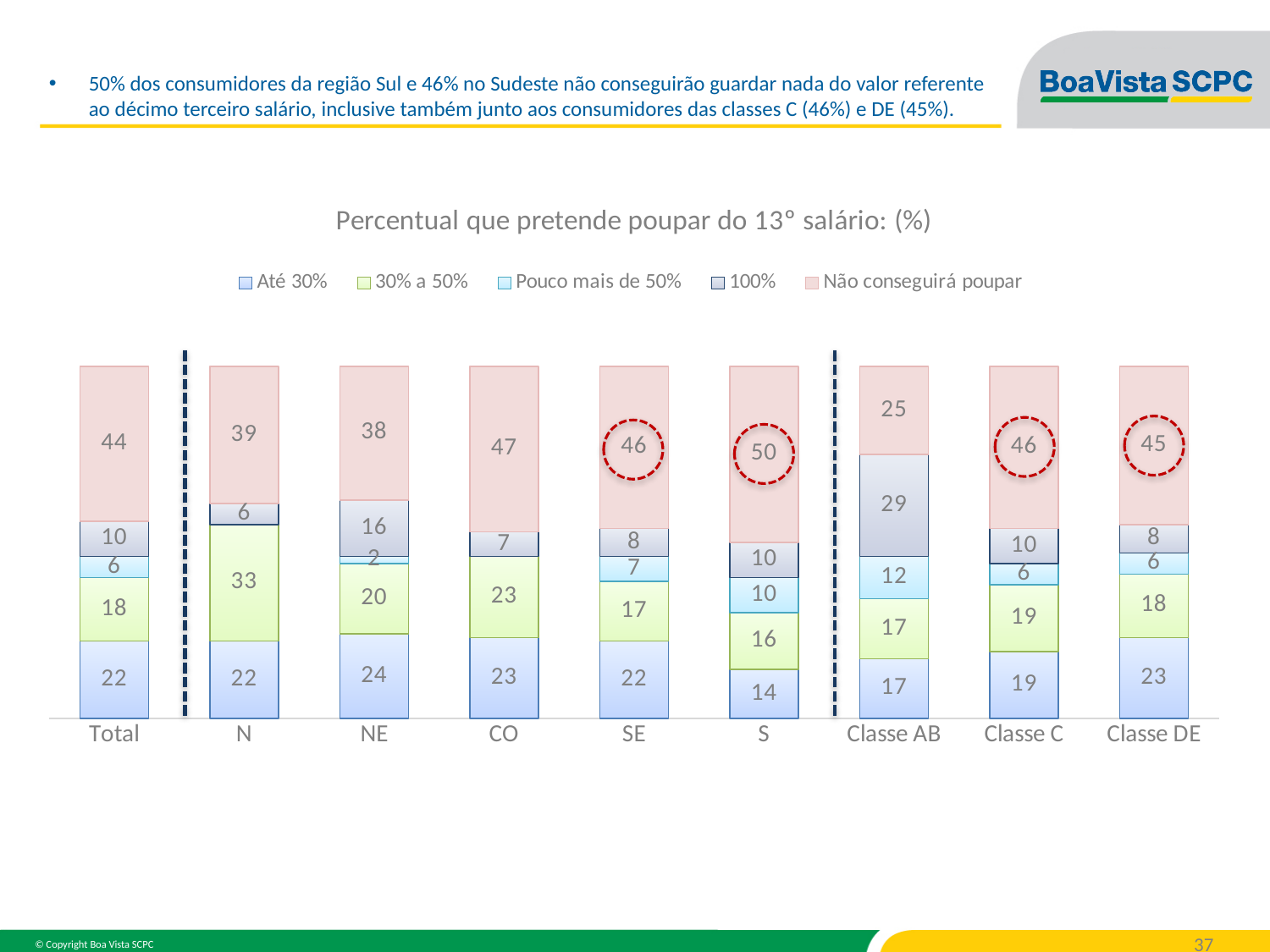
How many series does the legend list? 5 Which category has the lowest value for "Não conseguirá poupar"? Classe AB What is the value of "Até 30%" for NE? 24 What is the value of "100%" for Classe AB? 29 Which category has the highest value for "Não conseguirá poupar"? S What is the value of "Não conseguirá poupar" for S? 50 What kind of chart is shown on the slide? Stacked bar chart What is the value of "Pouco mais de 50%" for Classe AB? 12 Which category has the highest value for "30% a 50%"? N How many categories are shown on the x axis? 9 Which has a larger "30% a 50%" value, N or NE? N What is the difference between the "Não conseguirá poupar" values for SE and Classe AB? 21